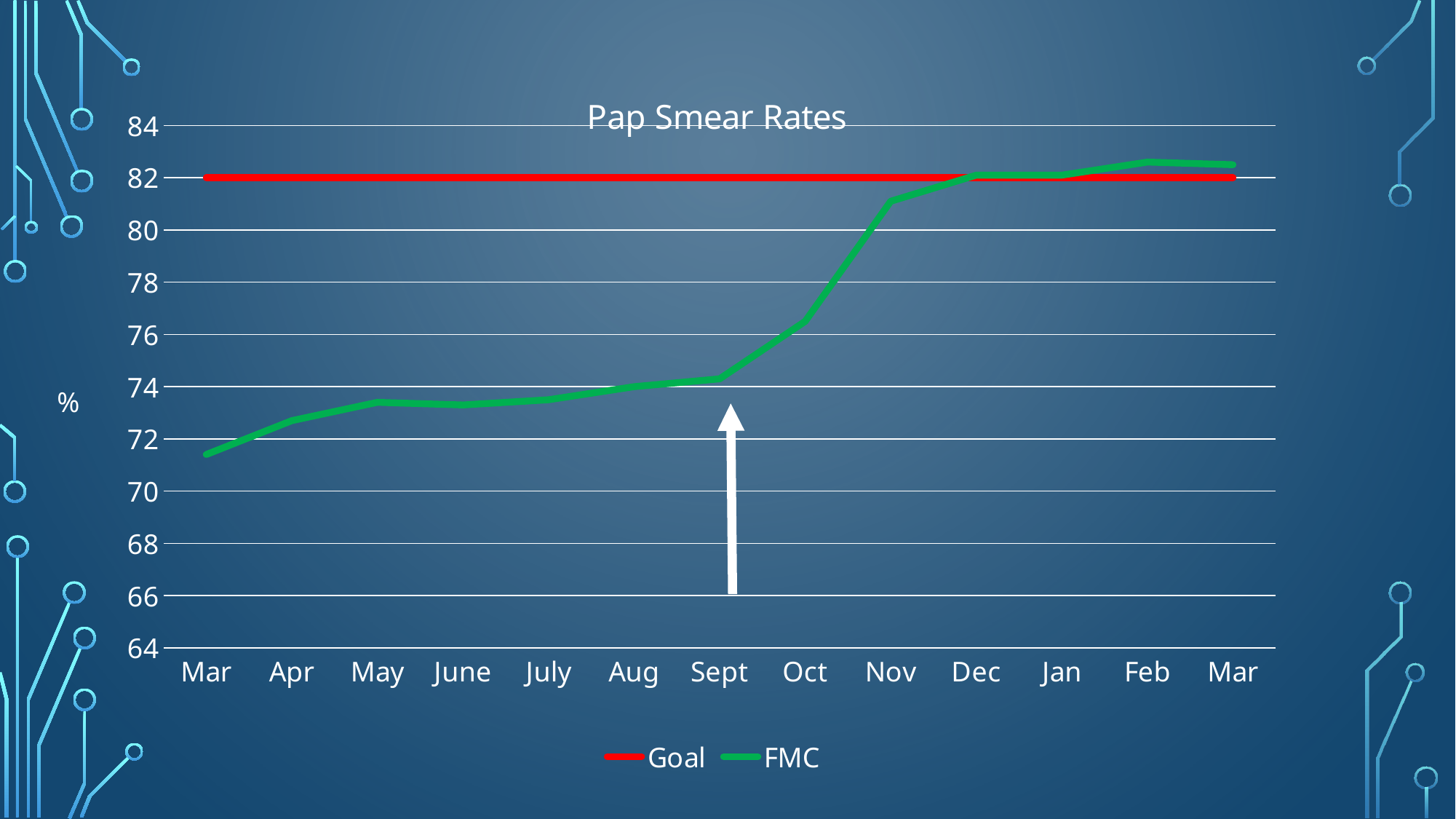
Does the FMC line generally rise or fall from the first Mar to the last Mar? rise Is the FMC value for the first Mar greater or less than 72? less Which colour is used for the FMC series? green How many series does the legend list? 2 Is the FMC value for Nov greater or less than 80? greater In which month is the FMC value lowest? Mar (the first Mar) How many months are plotted along the x axis? 13 Which is larger, the FMC value for Nov or for Sept? Nov Is the FMC value for May greater or less than 74? less What kind of chart is shown on the slide? line chart What is the title of the chart? Pap Smear Rates What value does the Goal line sit at? 82